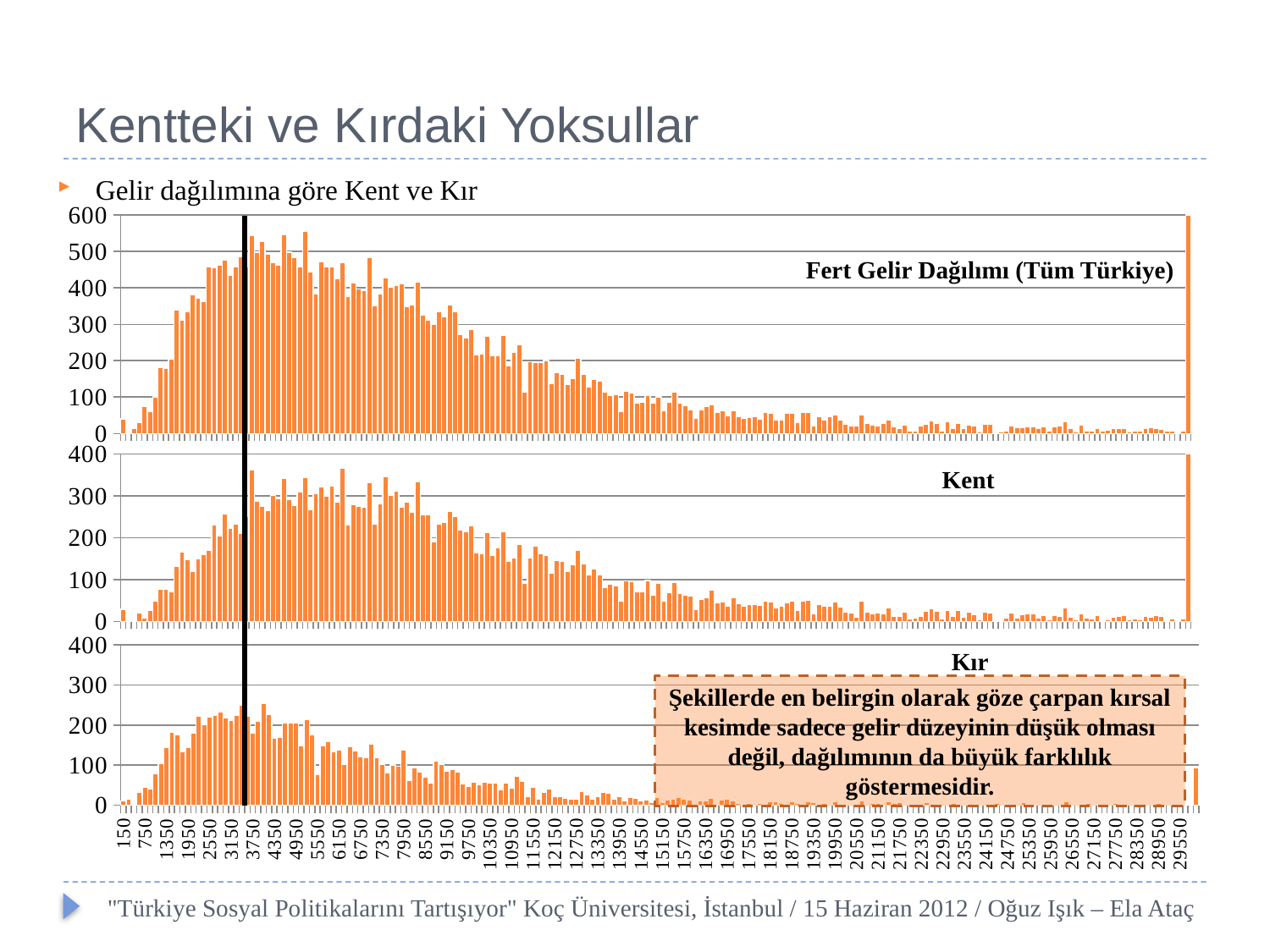
In the top chart 'Fert Gelir Dağılımı (Tüm Türkiye)', is the value for the 150 bin greater or less than 100? less In the 'Kır' chart, do the bar values generally rise or fall along the x axis after the 3750 bin? Fall What is the title of the middle chart? Kent What kind of chart is used for the 'Fert Gelir Dağılımı (Tüm Türkiye)' panel? Bar chart How many charts (panels) are shown on the slide? 3 In the 'Kent' chart, is the value for the 150 bin greater or less than 100? less In the 'Kır' chart, is the value for the 29550 bin greater or less than 200? less What is the maximum value shown on the y axis of the top chart 'Fert Gelir Dağılımı (Tüm Türkiye)'? 600